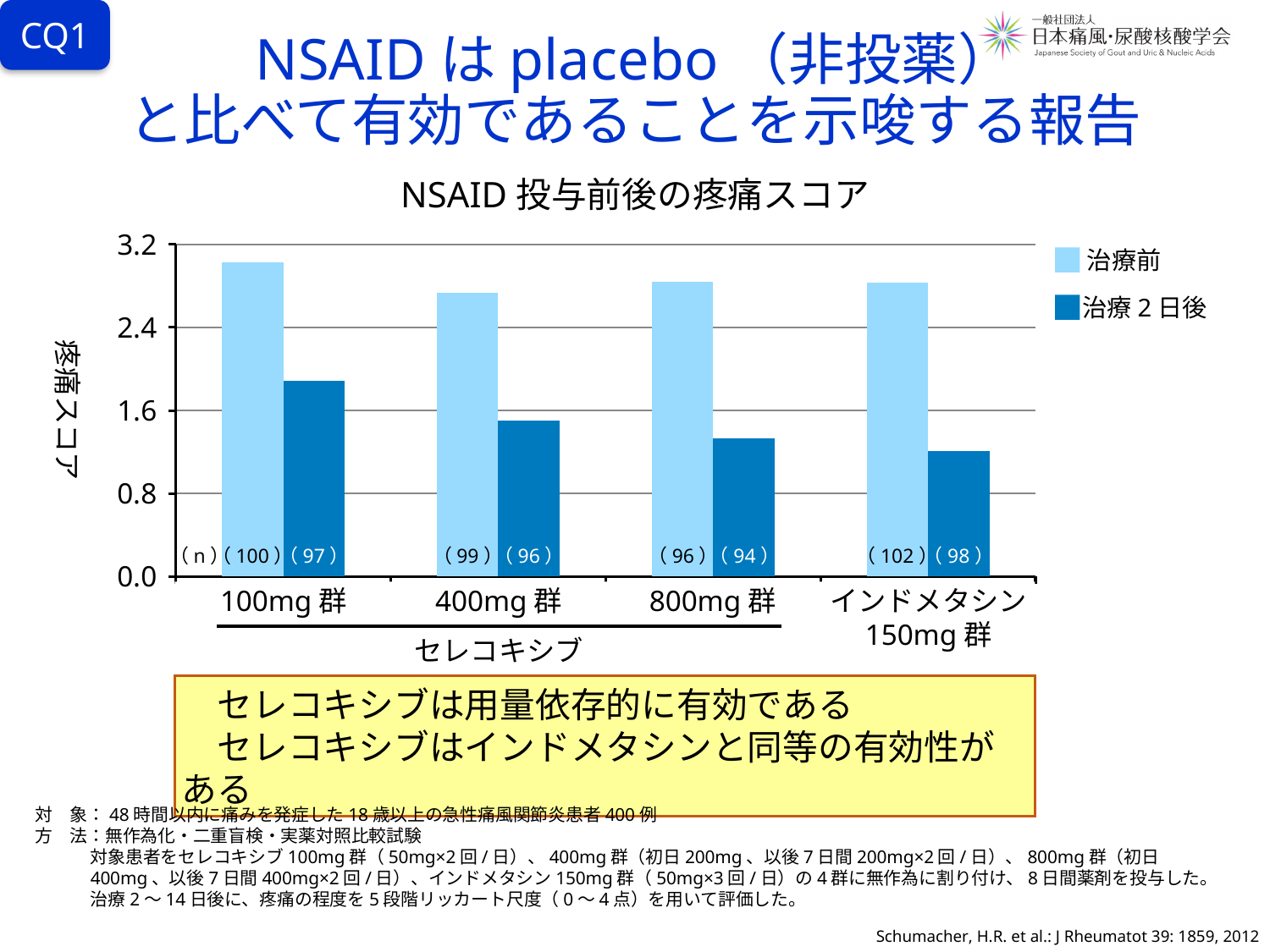
For the 800mg 群, which is larger: the 治療前 value or the 治療 2 日後 value? 治療前 Which group has the highest 治療 2 日後 pain score? 100mg 群 Is the 治療 2 日後 value for the 100mg 群 greater or less than 1.6? greater What is the label of the y axis? 疼痛スコア Is the 治療前 value for the 400mg 群 greater or less than 2.4? greater Which group has the highest 治療前 pain score? 100mg 群 Is the 治療 2 日後 value for the インドメタシン 150mg 群 greater or less than 1.6? less How many treatment groups (categories) are shown on the x axis? 4 What kind of chart is shown on the slide? bar chart What is the n value printed for the 治療 2 日後 bar of the インドメタシン 150mg 群? 98 How many series does the legend list? 2 What is the title of the chart? NSAID 投与前後の疼痛スコア